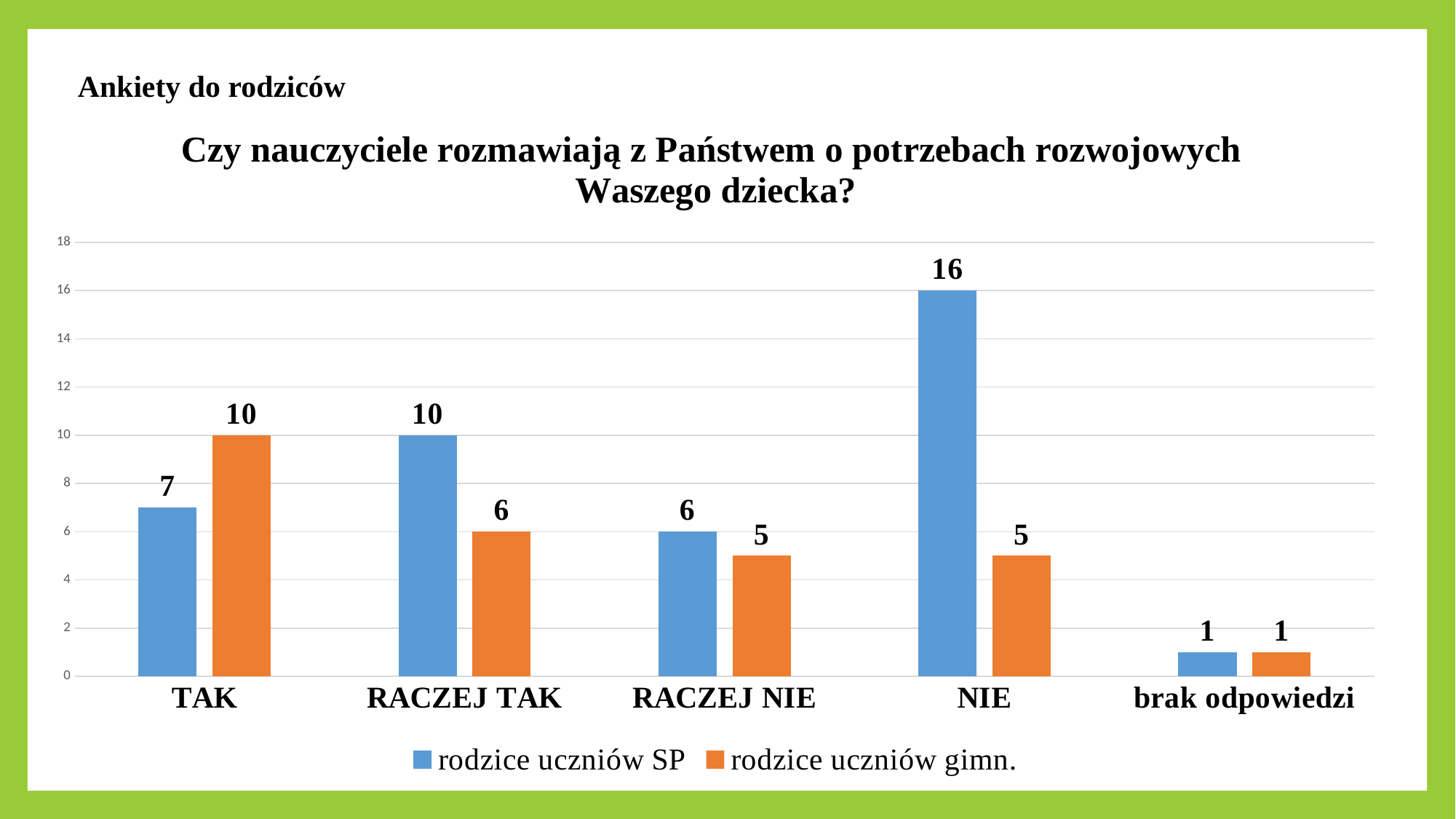
Is the value for 'rodzice uczniów SP' in the 'NIE' category greater or less than 14? greater How many categories are shown on the x axis? 5 Which category has the highest value for 'rodzice uczniów SP'? NIE What is the value for 'rodzice uczniów gimn.' in the 'TAK' category? 10 Which category has the lowest value for 'rodzice uczniów gimn.'? brak odpowiedzi What is the difference between 'rodzice uczniów SP' and 'rodzice uczniów gimn.' in the 'NIE' category? 11 What kind of chart is shown on the slide? bar chart What is the value for 'rodzice uczniów SP' in the 'NIE' category? 16 In the 'TAK' category, which series has the larger value: 'rodzice uczniów SP' or 'rodzice uczniów gimn.'? rodzice uczniów gimn. How many series does the legend list? 2 What colour are the bars for 'rodzice uczniów gimn.'? orange What is the value for 'rodzice uczniów SP' in the 'RACZEJ NIE' category? 6